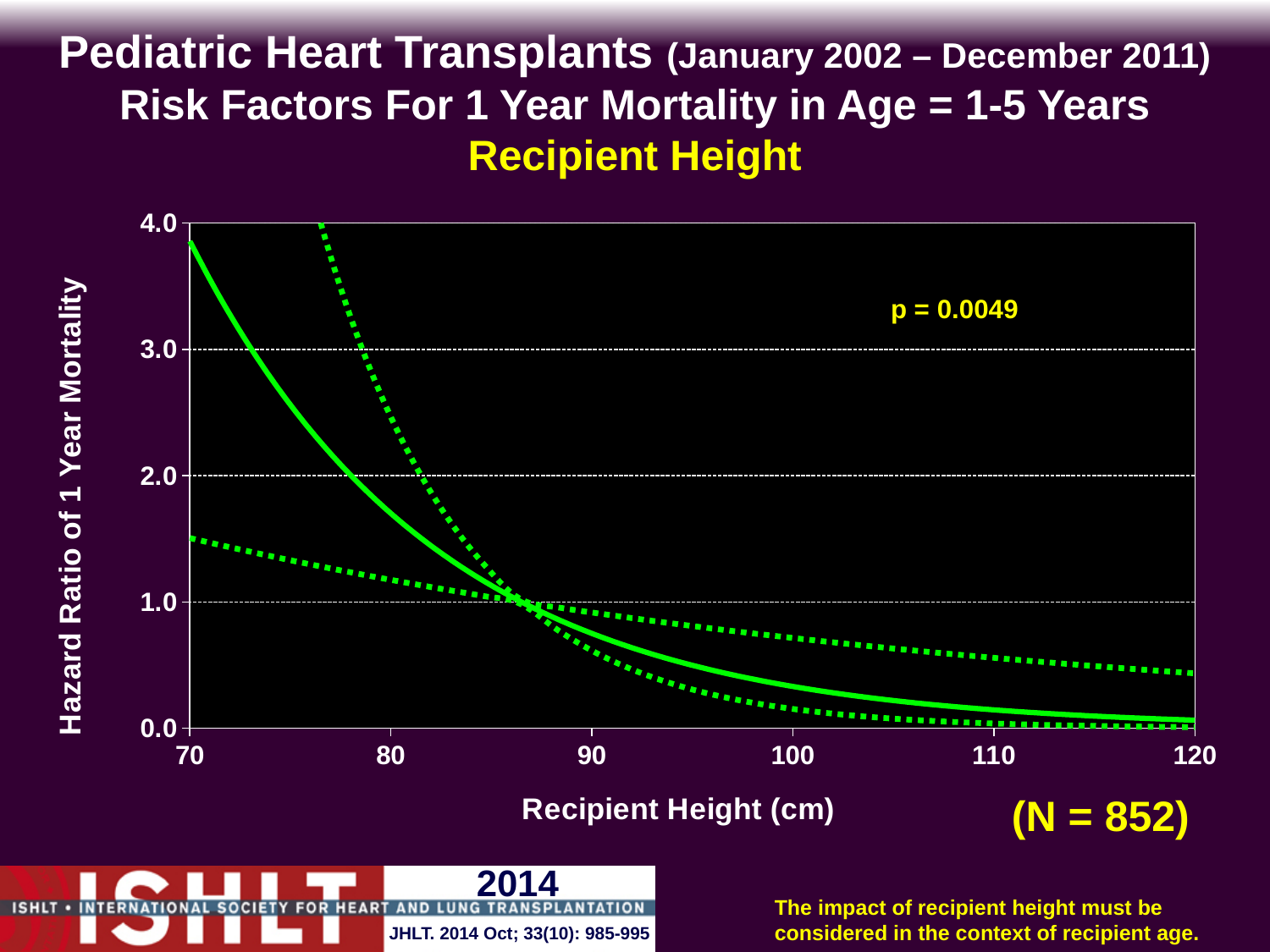
What p-value is printed on the chart? p = 0.0049 What is the label of the x axis? Recipient Height (cm) Is the hazard ratio on the solid line at a recipient height of 70 cm greater or less than 3.0? greater What is the highest value shown on the y axis? 4.0 Is the hazard ratio on the solid line at a recipient height of 120 cm greater or less than 1.0? less What kind of chart is shown on the slide? line chart What is the label of the y axis? Hazard Ratio of 1 Year Mortality Does the hazard ratio shown by the solid line rise or fall as recipient height increases from 70 cm to 120 cm? fall What sample size (N) is printed on the slide? N = 852 Is the hazard ratio on the solid line at a recipient height of 100 cm greater or less than 1.0? less How many lines (solid and dotted) are plotted on the chart? 3